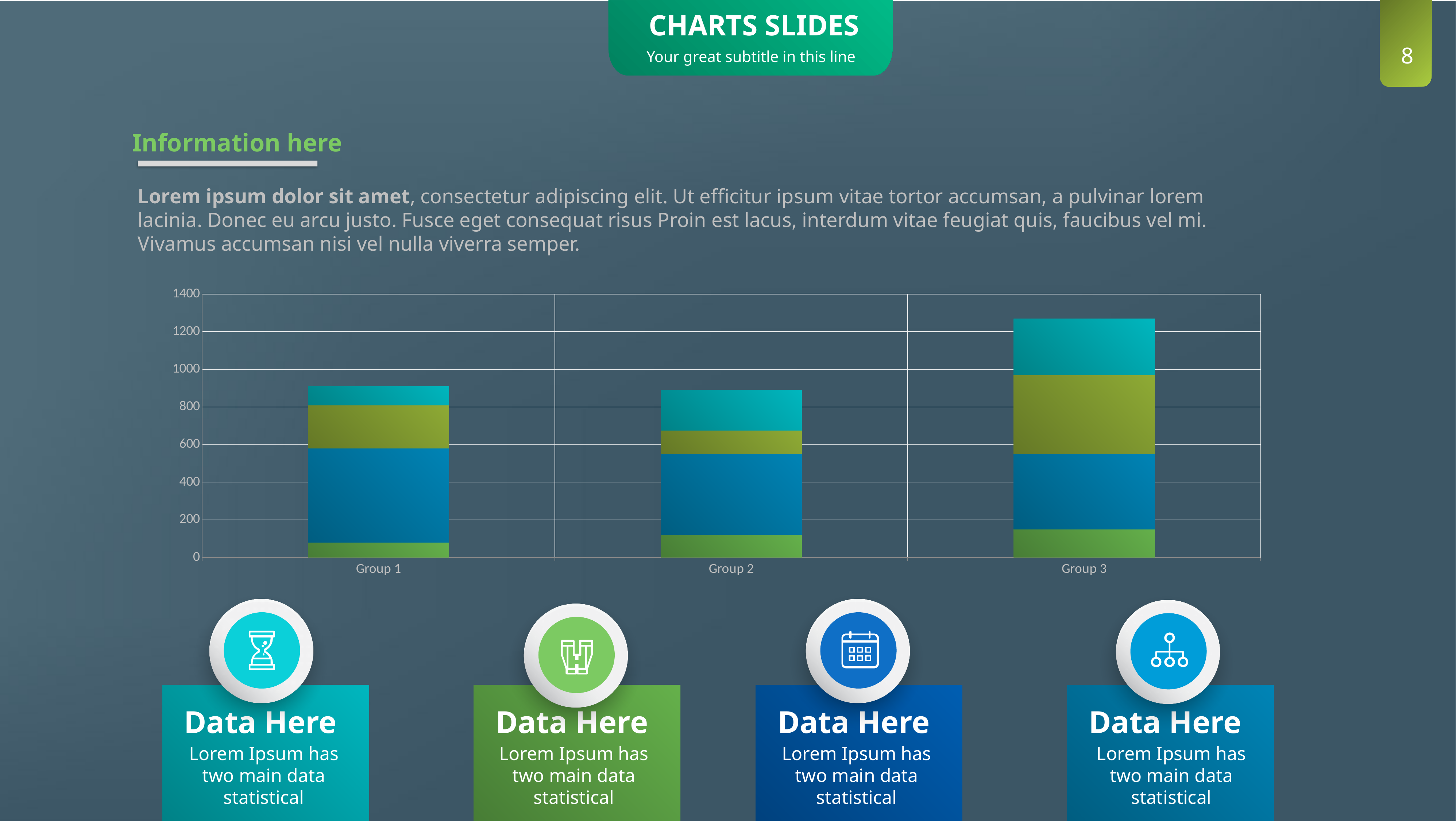
Which stacked bar is taller, Group 2 or Group 3? Group 3 Is the total stacked bar for Group 1 greater or less than 800? greater Which category has the tallest stacked bar? Group 3 Is the total stacked bar for Group 3 greater or less than 1200? greater How many categories are shown on the x axis of the chart? 3 Is the total stacked bar for Group 3 greater or less than 1400? less What is the highest value shown on the y axis of the chart? 1400 Which stacked bar is taller, Group 3 or Group 1? Group 3 What kind of chart is shown on the slide? Stacked bar chart How many coloured segments make up each stacked bar? 4